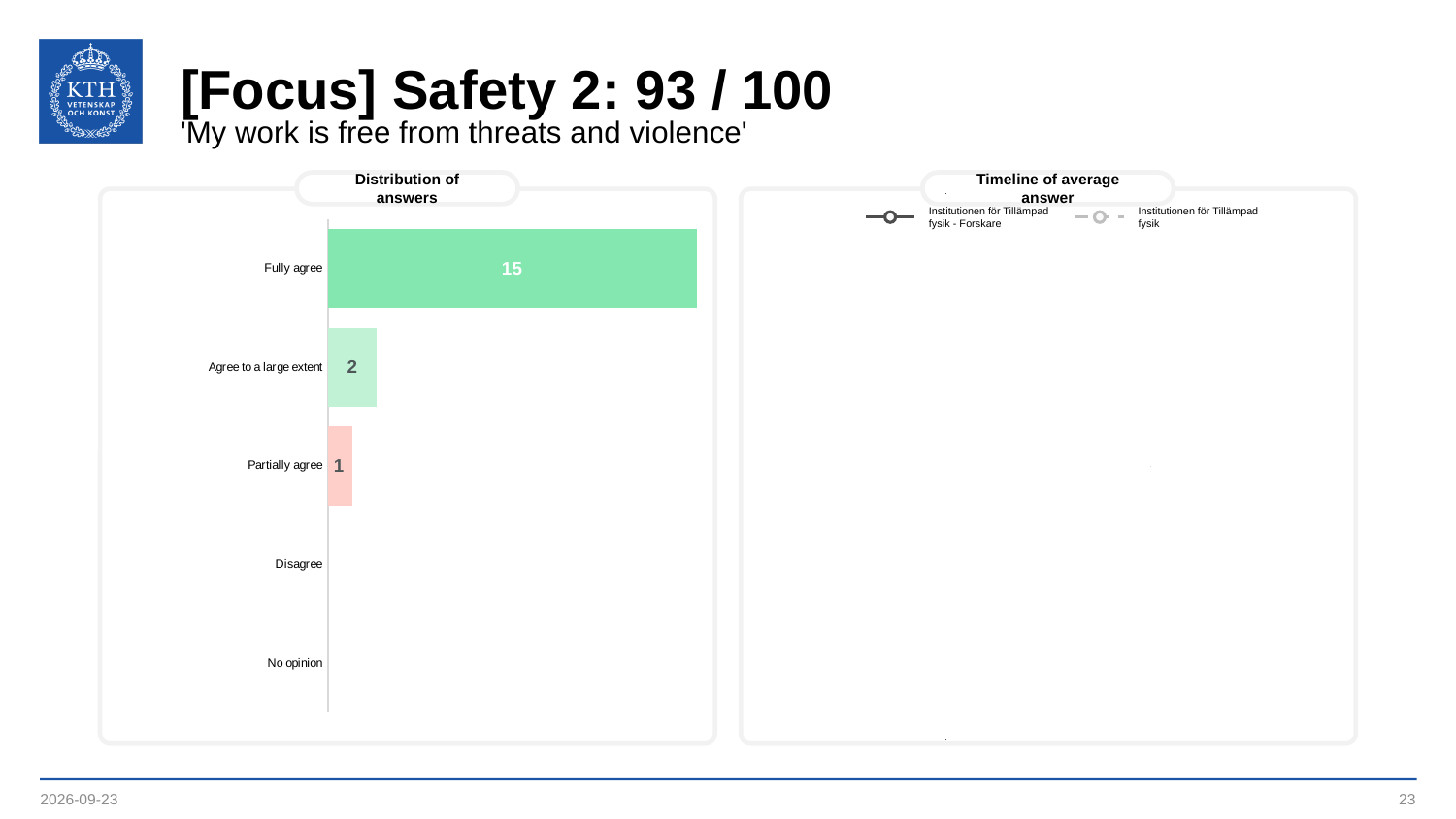
What is the title of the chart on the left of the slide? Distribution of answers How many categories are listed on the axis of the 'Distribution of answers' chart? 5 In the 'Distribution of answers' chart, what is the difference between 'Fully agree' and 'Agree to a large extent'? 13 In the 'Distribution of answers' chart, what is the value for 'Fully agree'? 15 In the 'Distribution of answers' chart, which category has the highest value? Fully agree In the 'Distribution of answers' chart, which categories have no bar shown? Disagree and No opinion How many series does the legend of the 'Timeline of average answer' chart list? 2 In the 'Distribution of answers' chart, what is the total of the three labelled bars? 18 In the 'Distribution of answers' chart, which is larger: 'Agree to a large extent' or 'Partially agree'? Agree to a large extent In the 'Distribution of answers' chart, what is the value for 'Agree to a large extent'? 2 What kind of chart is the 'Distribution of answers' chart? Bar chart In the 'Distribution of answers' chart, what is the value for 'Partially agree'? 1